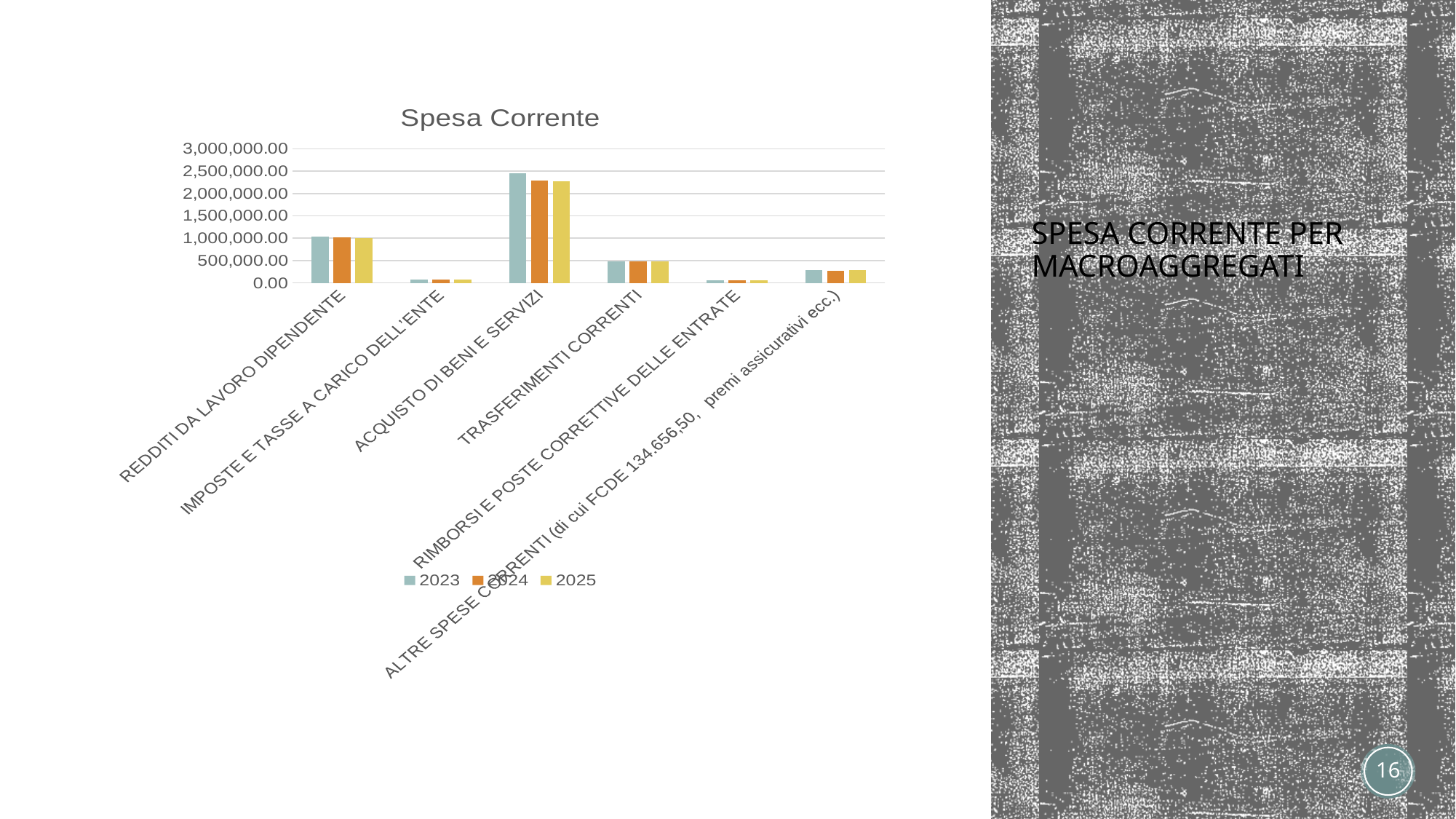
Which years are listed in the chart legend? 2023, 2024, 2025 Is the 2023 value for ALTRE SPESE CORRENTI greater or less than 500,000.00? less Which is larger: the 2023 value for REDDITI DA LAVORO DIPENDENTE or the 2023 value for TRASFERIMENTI CORRENTI? REDDITI DA LAVORO DIPENDENTE Is the 2024 value for TRASFERIMENTI CORRENTI greater or less than 1,000,000.00? less Is the 2023 value for ACQUISTO DI BENI E SERVIZI greater or less than 2,000,000.00? greater Which category has the highest values in the chart? ACQUISTO DI BENI E SERVIZI Which is larger for ACQUISTO DI BENI E SERVIZI: the 2023 value or the 2024 value? 2023 What is the title of the chart? Spesa Corrente How many categories are shown on the x axis of the chart? 6 What kind of chart is shown on the slide? bar chart How many series does the legend list? 3